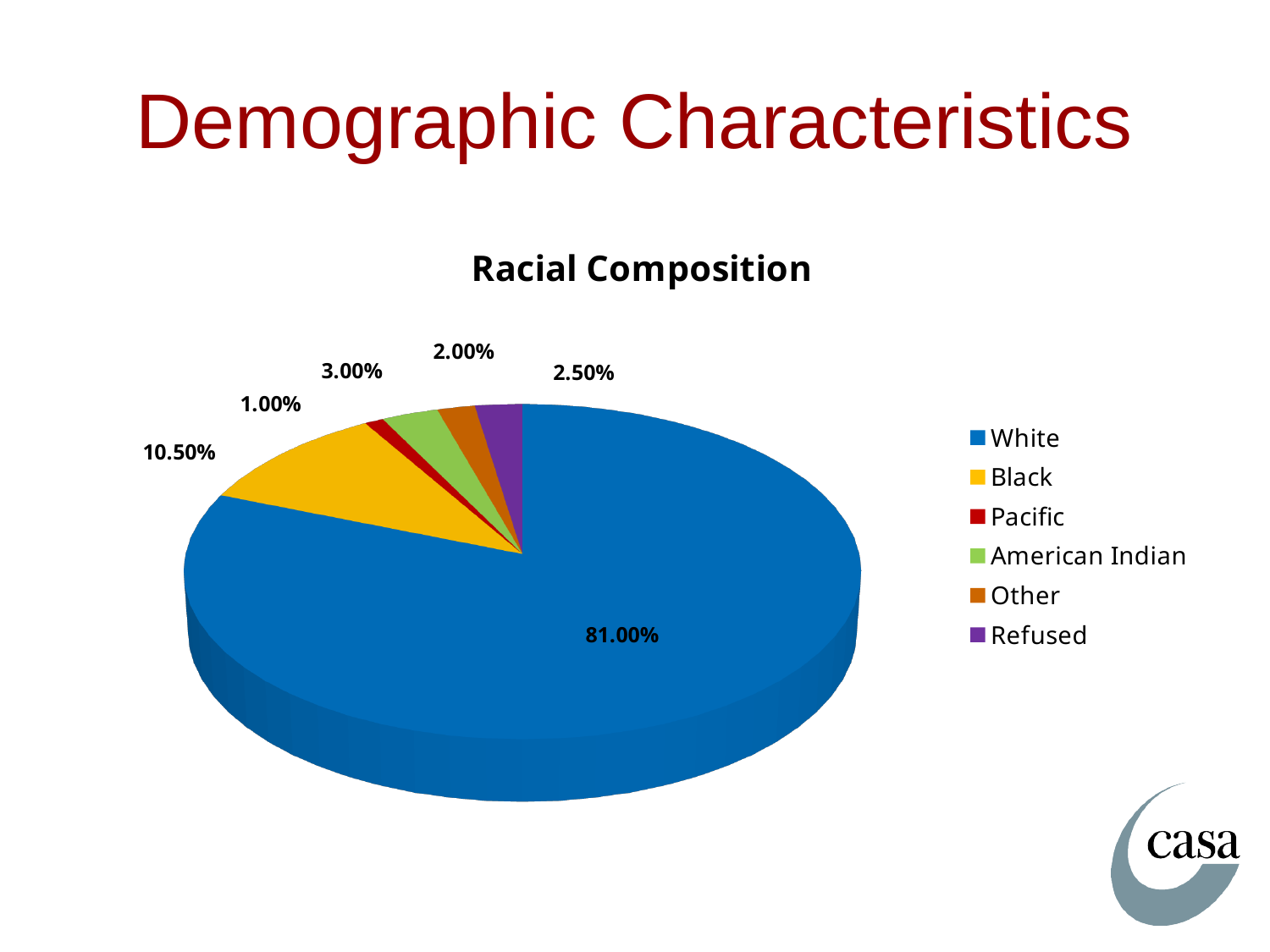
How many categories does the legend list? 6 What percentage of the pie is labelled for Black? 10.50% Which category has the largest slice of the pie? White What percentage of the pie is labelled for Refused? 2.50% Which category has the smallest slice of the pie? Pacific What percentage of the pie is labelled for White? 81.00% Which is larger, the slice for Other or the slice for Refused? Refused What colour is the slice for Black? yellow What type of chart is shown on the slide? pie chart What is the difference between the White and Black percentages? 70.50% What percentage of the pie is labelled for American Indian? 3.00% What is the title of the chart? Racial Composition